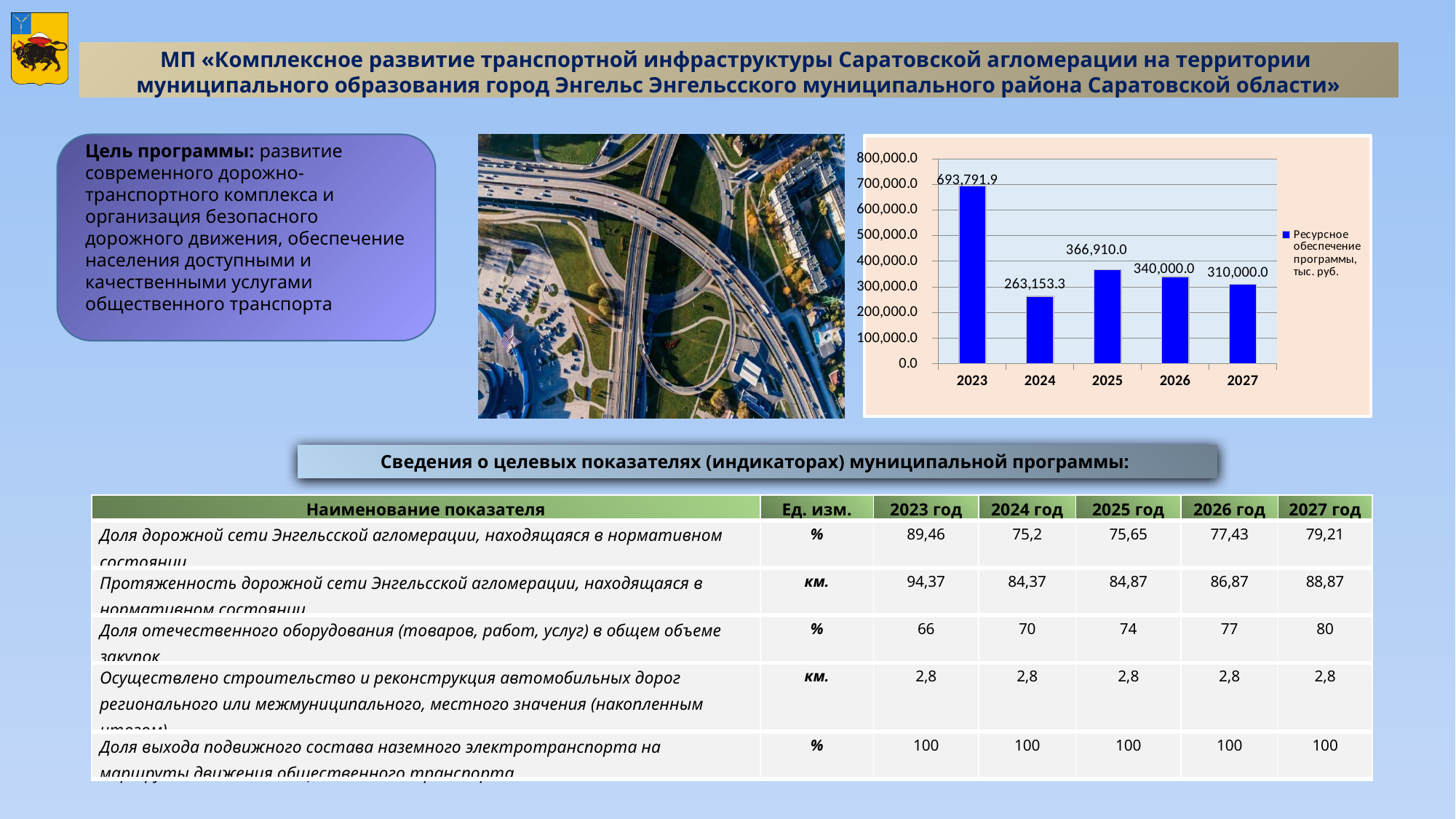
Which is larger in the bar chart, the value for 2025 or the value for 2026? 2025 What is the value for 2023 in the bar chart? 693,791.9 Is the value for 2024 in the bar chart greater or less than 300,000.0? less How many years are shown on the x axis of the bar chart? 5 Which year has the highest value in the bar chart? 2023 What is the value for 2027 in the bar chart? 310,000.0 Which year has the lowest value in the bar chart? 2024 What is the value for 2025 in the bar chart? 366,910.0 What is the difference between the values for 2026 and 2027 in the bar chart? 30,000.0 What is the difference between the values for 2025 and 2026 in the bar chart? 26,910.0 What is the value for 2024 in the bar chart? 263,153.3 What type of chart is shown on the slide? bar chart